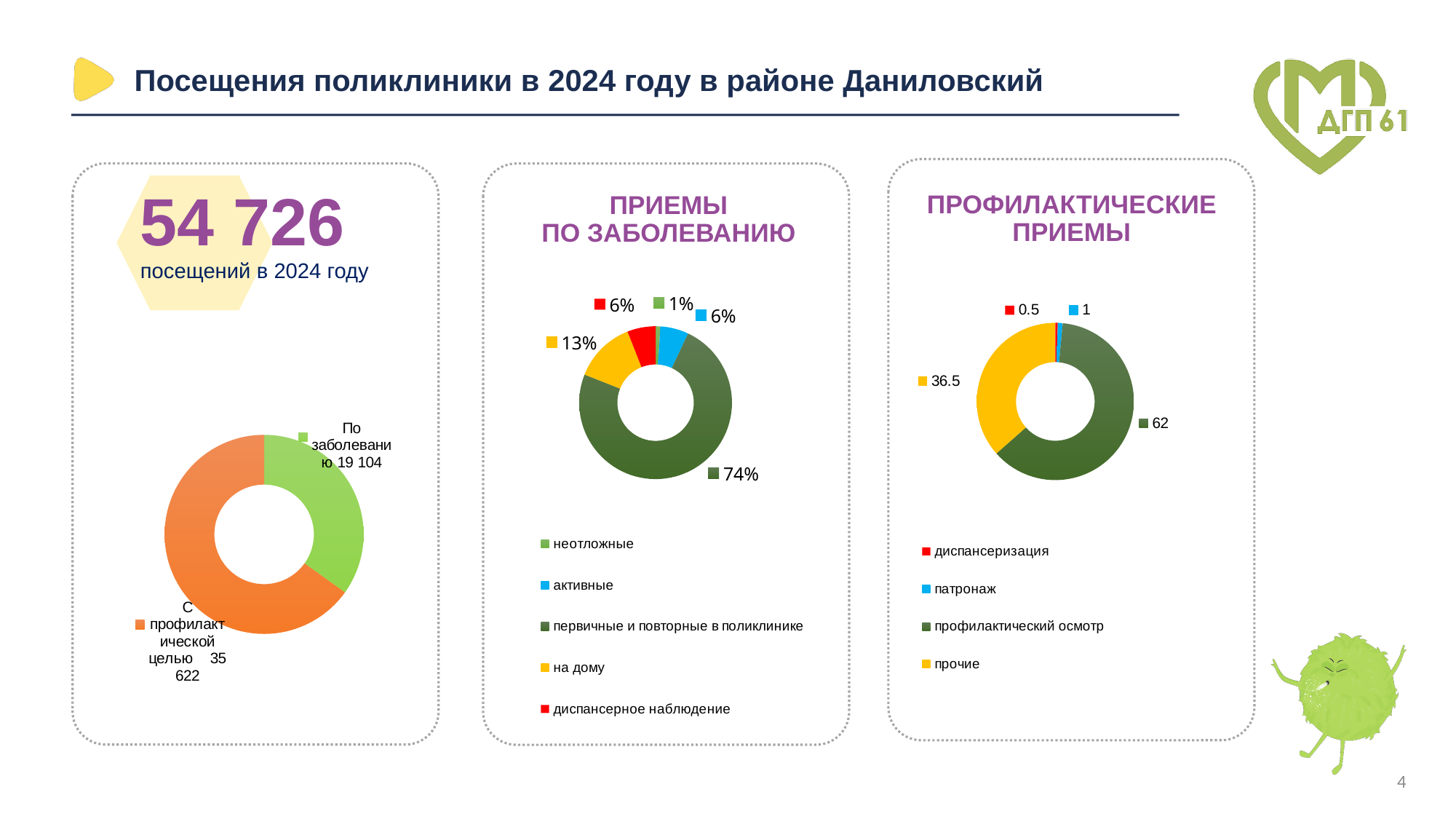
In the left donut chart, what is the value for 'С профилактической целью'? 35 622 How many categories does the legend of the chart 'ПРИЕМЫ ПО ЗАБОЛЕВАНИЮ' list? 5 In the left donut chart, what is the difference between 'С профилактической целью' and 'По заболеванию'? 16 518 What type of chart is used for 'ПРОФИЛАКТИЧЕСКИЕ ПРИЕМЫ'? Donut (pie) chart In the left donut chart, which of the two categories is larger: 'По заболеванию' or 'С профилактической целью'? С профилактической целью In the chart 'ПРИЕМЫ ПО ЗАБОЛЕВАНИЮ', which category has the smallest share? неотложные In the left donut chart, what is the value for 'По заболеванию'? 19 104 In the chart 'ПРИЕМЫ ПО ЗАБОЛЕВАНИЮ', what share do 'первичные и повторные в поликлинике' have? 74% In the chart 'ПРОФИЛАКТИЧЕСКИЕ ПРИЕМЫ', which category has the lowest value? диспансеризация In the chart 'ПРОФИЛАКТИЧЕСКИЕ ПРИЕМЫ', what is the value for 'профилактический осмотр'? 62 In the chart 'ПРОФИЛАКТИЧЕСКИЕ ПРИЕМЫ', what is the value for 'прочие'? 36.5 In the chart 'ПРИЕМЫ ПО ЗАБОЛЕВАНИЮ', what share do 'на дому' visits have? 13%